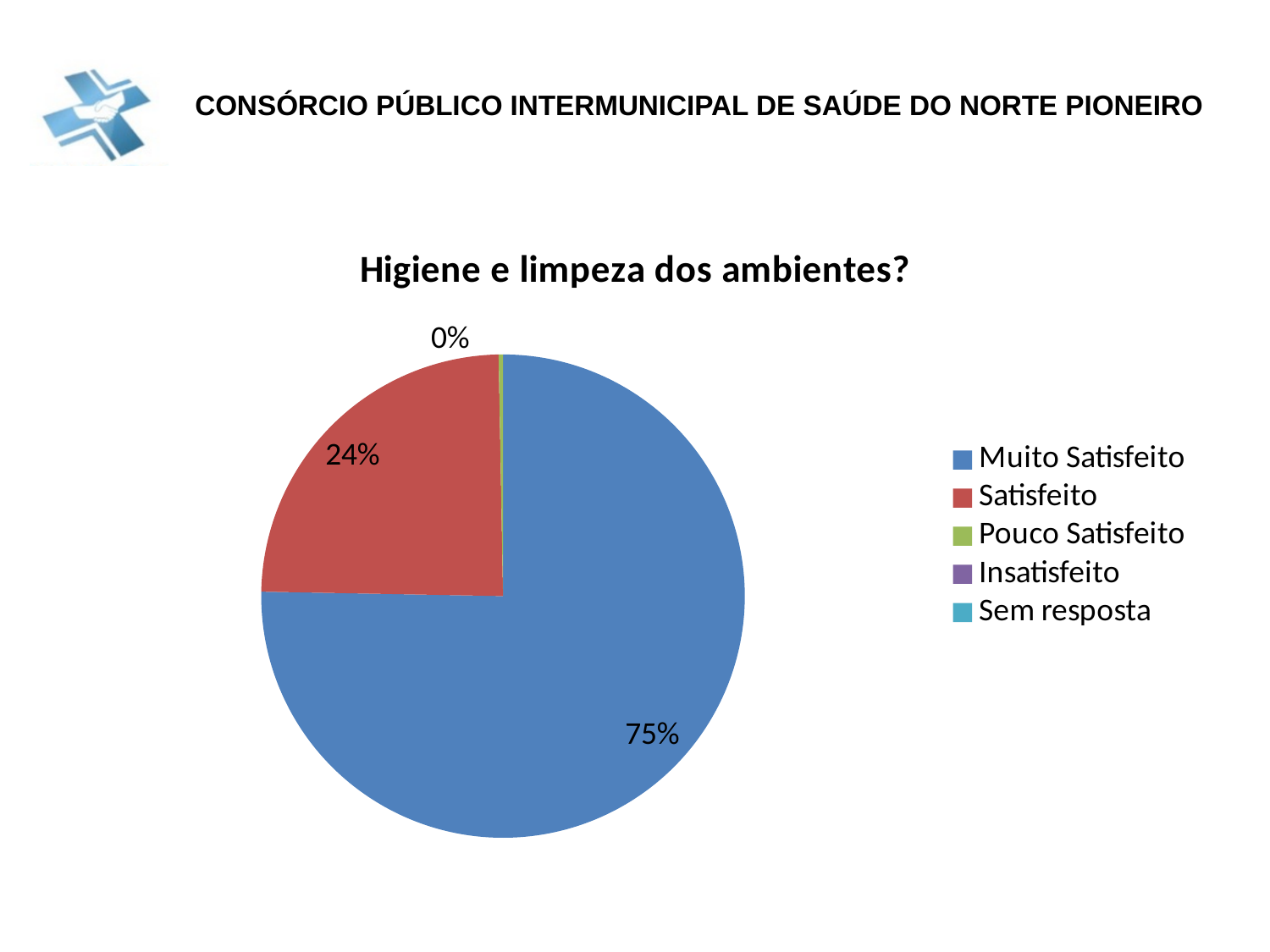
What percentage is labelled for Pouco Satisfeito? 0% What percentage of the pie is labelled for Satisfeito? 24% How many entries does the legend list? 5 What percentage of the pie is labelled for Muito Satisfeito? 75% What is the difference in percentage points between the Muito Satisfeito slice and the Satisfeito slice? 51 percentage points What colour is the Muito Satisfeito slice? blue What kind of chart is shown on the slide? pie chart Which is larger, the slice for Muito Satisfeito or the slice for Satisfeito? Muito Satisfeito What is the title of the chart? Higiene e limpeza dos ambientes? Which category has the largest slice of the pie? Muito Satisfeito What share of the pie does the Satisfeito slice represent? 24%